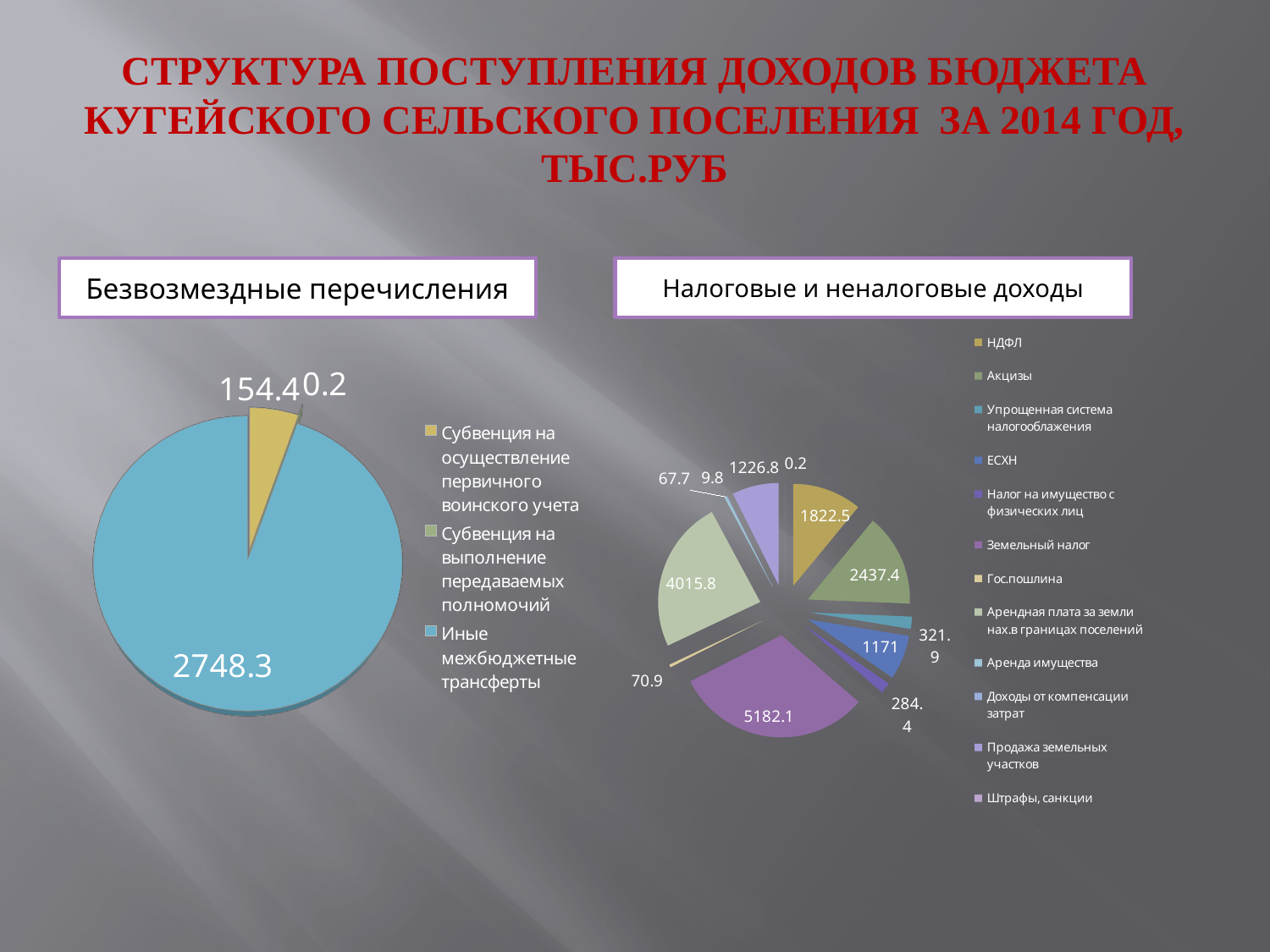
In the "Безвозмездные перечисления" chart, what is the value for "Субвенция на выполнение передаваемых полномочий"? 0.2 In the "Безвозмездные перечисления" chart, which category has the smallest slice? Субвенция на выполнение передаваемых полномочий In the "Налоговые и неналоговые доходы" chart, what is the difference between the two largest labeled values, 5182.1 and 4015.8? 1166.3 In the "Безвозмездные перечисления" chart, what is the difference between "Иные межбюджетные трансферты" and "Субвенция на осуществление первичного воинского учета"? 2593.9 In the "Безвозмездные перечисления" chart, what is the value for "Субвенция на осуществление первичного воинского учета"? 154.4 In the "Безвозмездные перечисления" chart, how many categories does the legend list? 3 In the "Безвозмездные перечисления" chart, which category has the largest slice? Иные межбюджетные трансферты In the "Налоговые и неналоговые доходы" chart, what is the largest data label shown? 5182.1 What type of chart is used for "Безвозмездные перечисления"? pie chart In the "Безвозмездные перечисления" chart, what is the value for "Иные межбюджетные трансферты"? 2748.3 In the "Налоговые и неналоговые доходы" chart, what is the smallest data label shown? 0.2 In the "Налоговые и неналоговые доходы" chart, how many categories does the legend list? 12